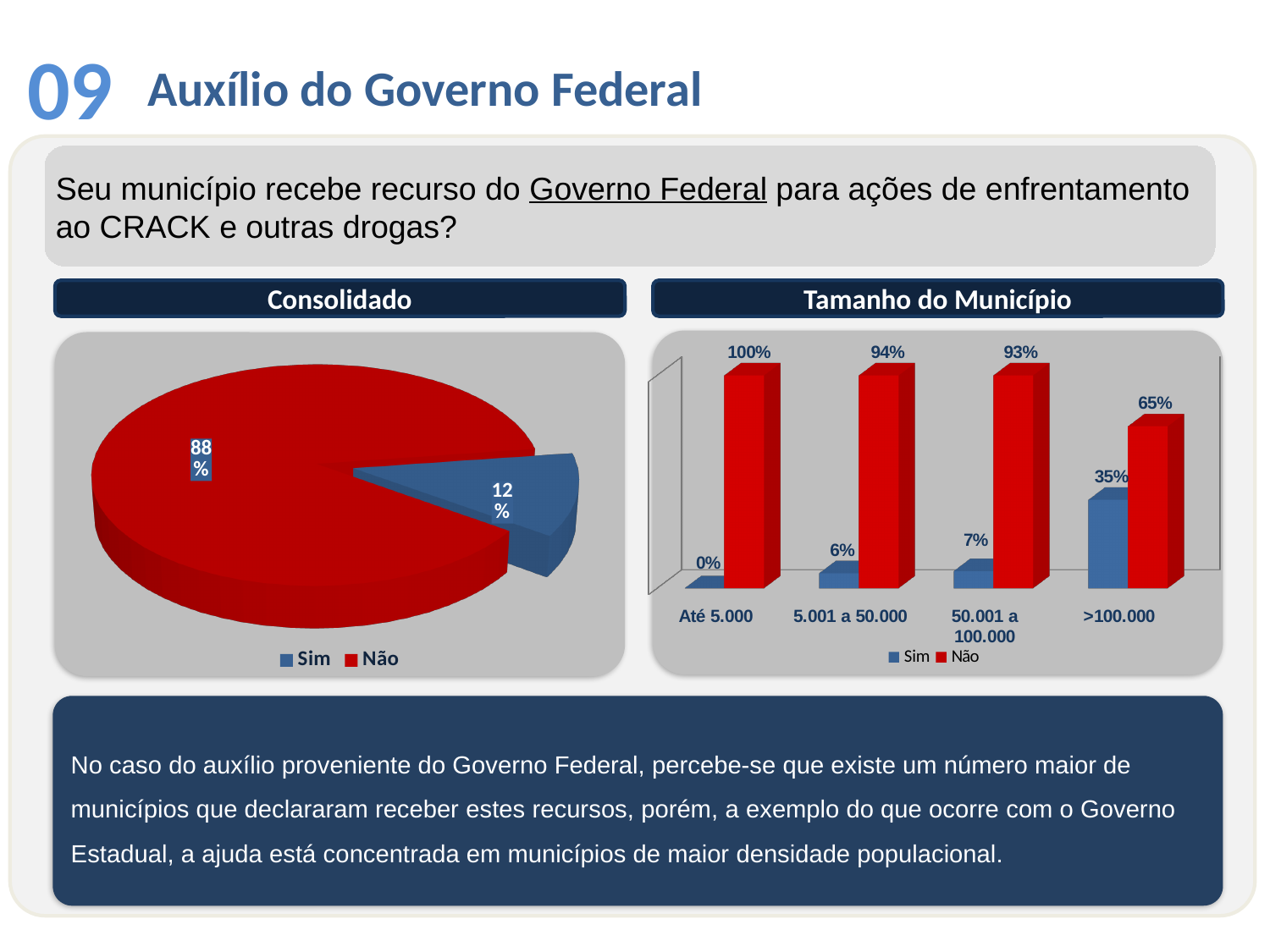
What kind of chart is the 'Tamanho do Município' chart? Bar chart In the 'Tamanho do Município' chart, what is the 'Sim' value for 'Até 5.000'? 0% In the 'Consolidado' chart, what share of the pie is 'Sim'? 12% In the 'Consolidado' chart, what share of the pie is 'Não'? 88% In the 'Tamanho do Município' chart, what is the 'Não' value for '5.001 a 50.000'? 94% In the 'Tamanho do Município' chart, which category has the lowest 'Não' value? >100.000 In the 'Tamanho do Município' chart, what is the 'Sim' value for '>100.000'? 35% What kind of chart is the 'Consolidado' chart? Pie chart In the 'Tamanho do Município' chart, which category has the highest 'Sim' value? >100.000 In the 'Tamanho do Município' chart, do the 'Sim' values rise or fall from 'Até 5.000' to '>100.000'? Rise In the 'Tamanho do Município' chart, what is the difference between the 'Não' and 'Sim' values for '50.001 a 100.000'? 86% How many categories are shown on the x axis of the 'Tamanho do Município' chart? 4